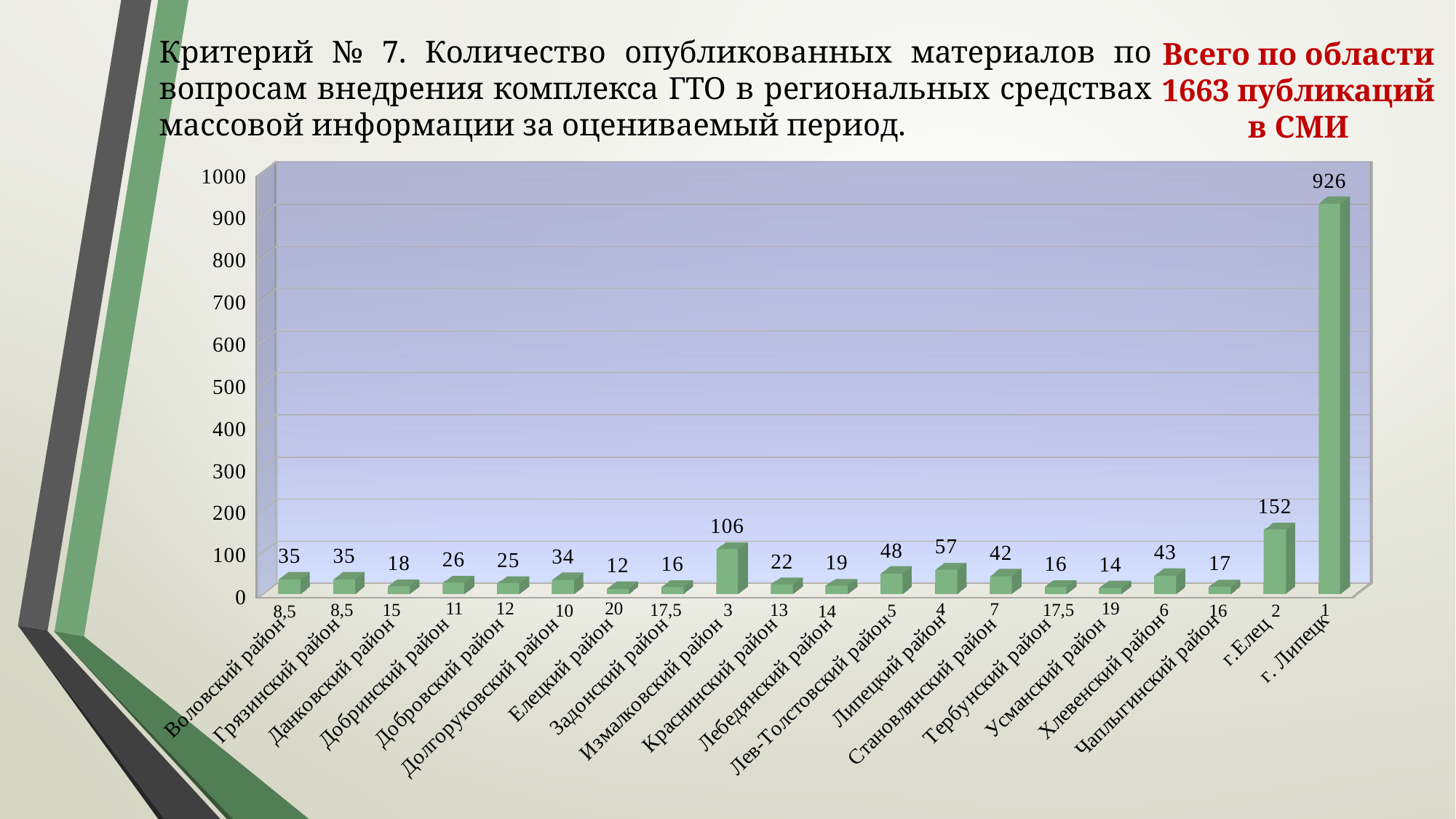
What is the difference between the values for г. Липецк and г.Елец? 774 What is the difference between the values for Лев-Толстовский район and Хлевенский район? 5 What is the value for г. Липецк? 926 Which is larger, the value for Становлянский район or the value for Долгоруковский район? Становлянский район What is the value for г.Елец? 152 What rank number is printed below the bar for Измалковский район? 3 What is the value for Измалковский район? 106 What kind of chart is shown on the slide? bar chart Which category has the highest value? г. Липецк How many categories are shown on the x axis? 20 What is the value for Липецкий район? 57 Which category has the lowest value? Елецкий район